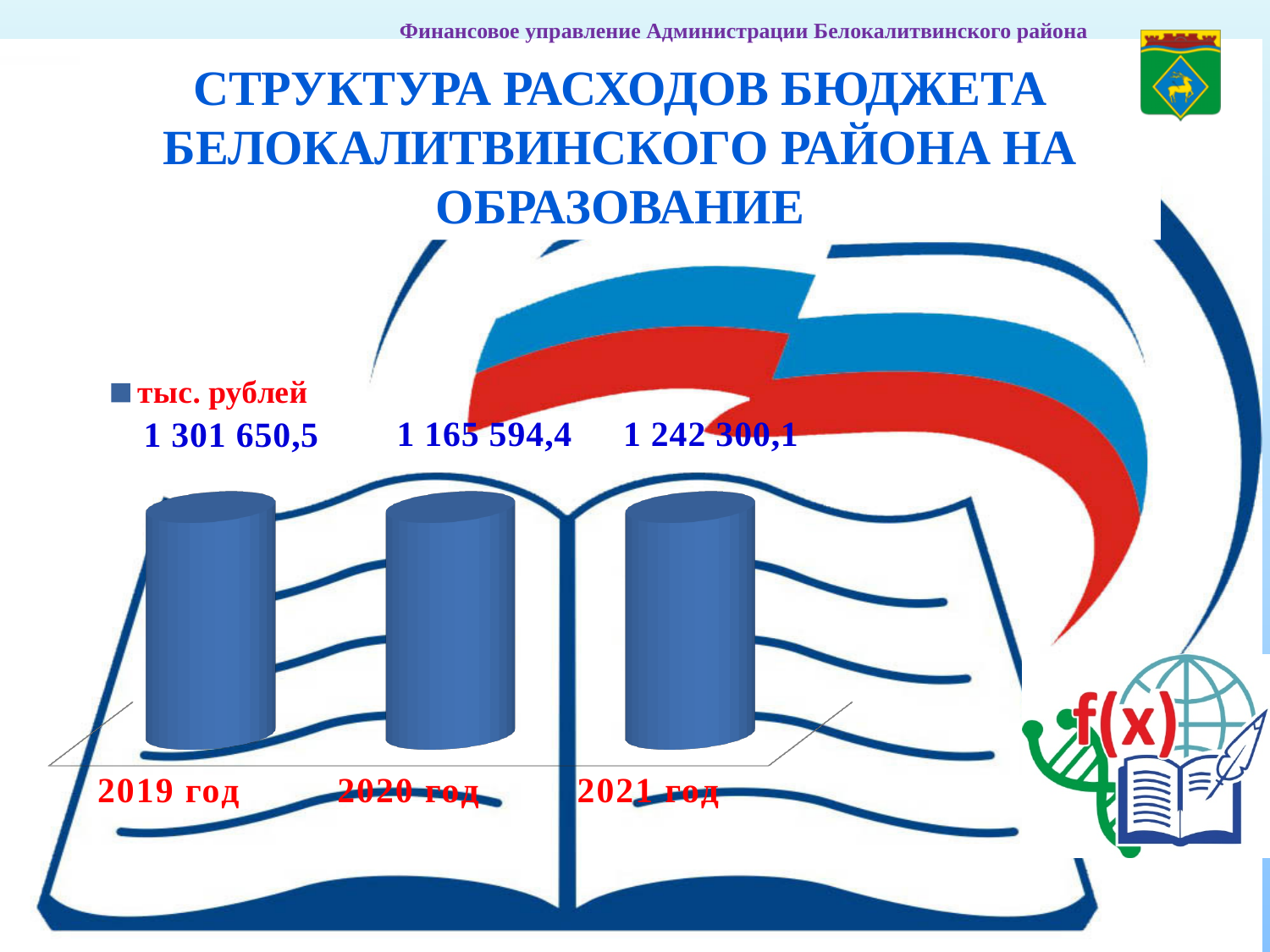
Which year has the lowest value? 2020 год What is the difference between the values for 2019 год and 2020 год? 136 056,1 How many series does the legend list? 1 What is the difference between the values for 2021 год and 2020 год? 76 705,7 Which year has the highest value? 2019 год What kind of chart is shown on the slide? bar chart What is the value for 2019 год? 1 301 650,5 What is the value for 2021 год? 1 242 300,1 How many years are shown on the chart? 3 What is the value for 2020 год? 1 165 594,4 Which is larger, the value for 2019 год or the value for 2021 год? 2019 год Do the values rise or fall from 2019 год to 2020 год? fall